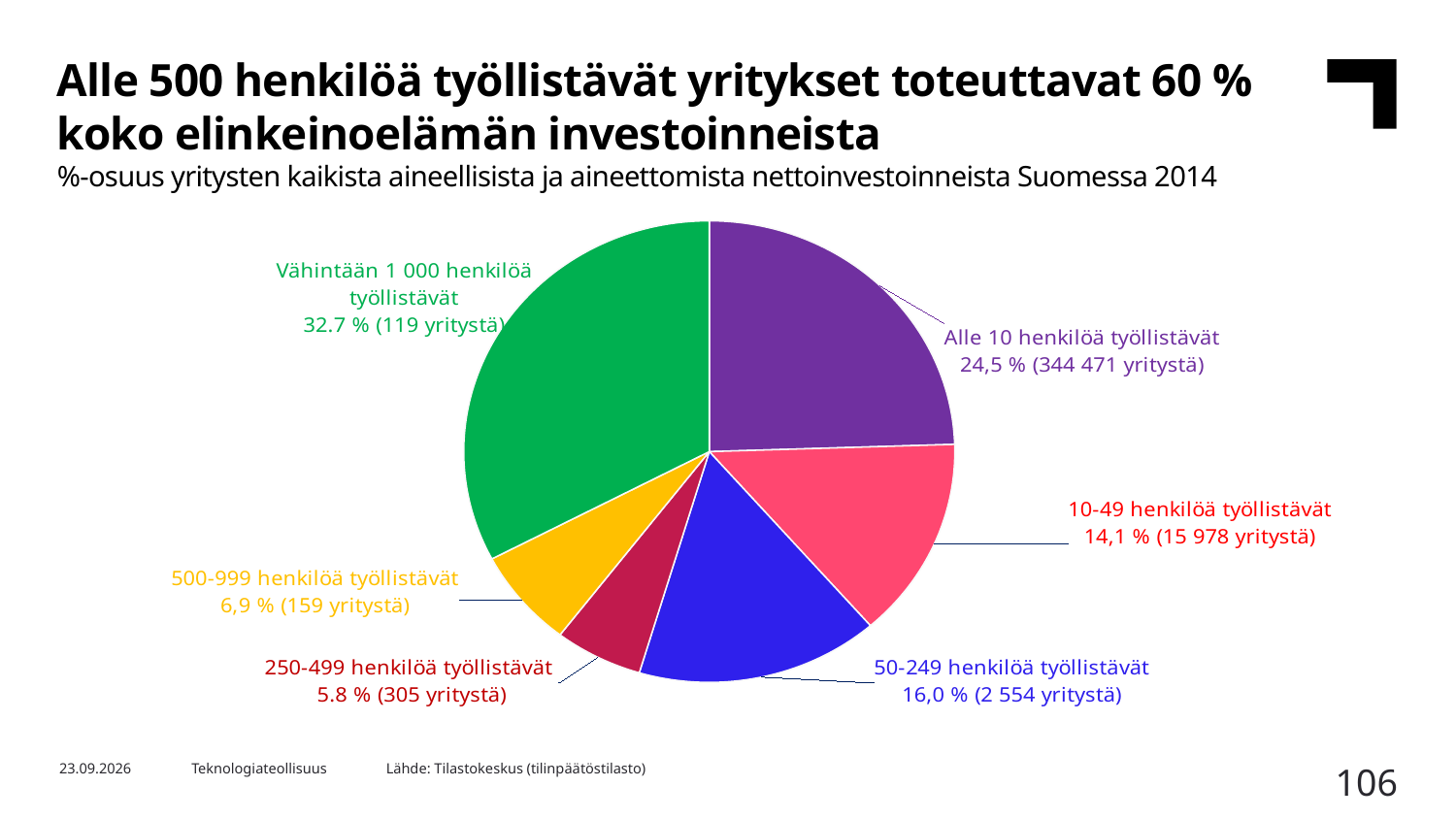
What share of net investments is attributed to companies employing fewer than 10 people (Alle 10 henkilöä työllistävät)? 24,5 % How many slices does the pie chart have? 6 Which category has the smallest share of the pie? 250-499 henkilöä työllistävät What share of net investments is attributed to companies employing at least 1 000 people (Vähintään 1 000 henkilöä työllistävät)? 32.7 % Which category has the largest share of the pie? Vähintään 1 000 henkilöä työllistävät What colour is the slice for Vähintään 1 000 henkilöä työllistävät? Green Which category has a larger share: 50-249 henkilöä työllistävät or 10-49 henkilöä työllistävät? 50-249 henkilöä työllistävät How many companies are in the 500-999 henkilöä työllistävät category? 159 How many companies are in the 10-49 henkilöä työllistävät category? 15 978 What share of net investments is attributed to companies employing 50-249 people? 16,0 % What is the difference in percentage points between the share of Alle 10 henkilöä työllistävät and 10-49 henkilöä työllistävät? 10,4 What type of chart is shown on the slide? Pie chart